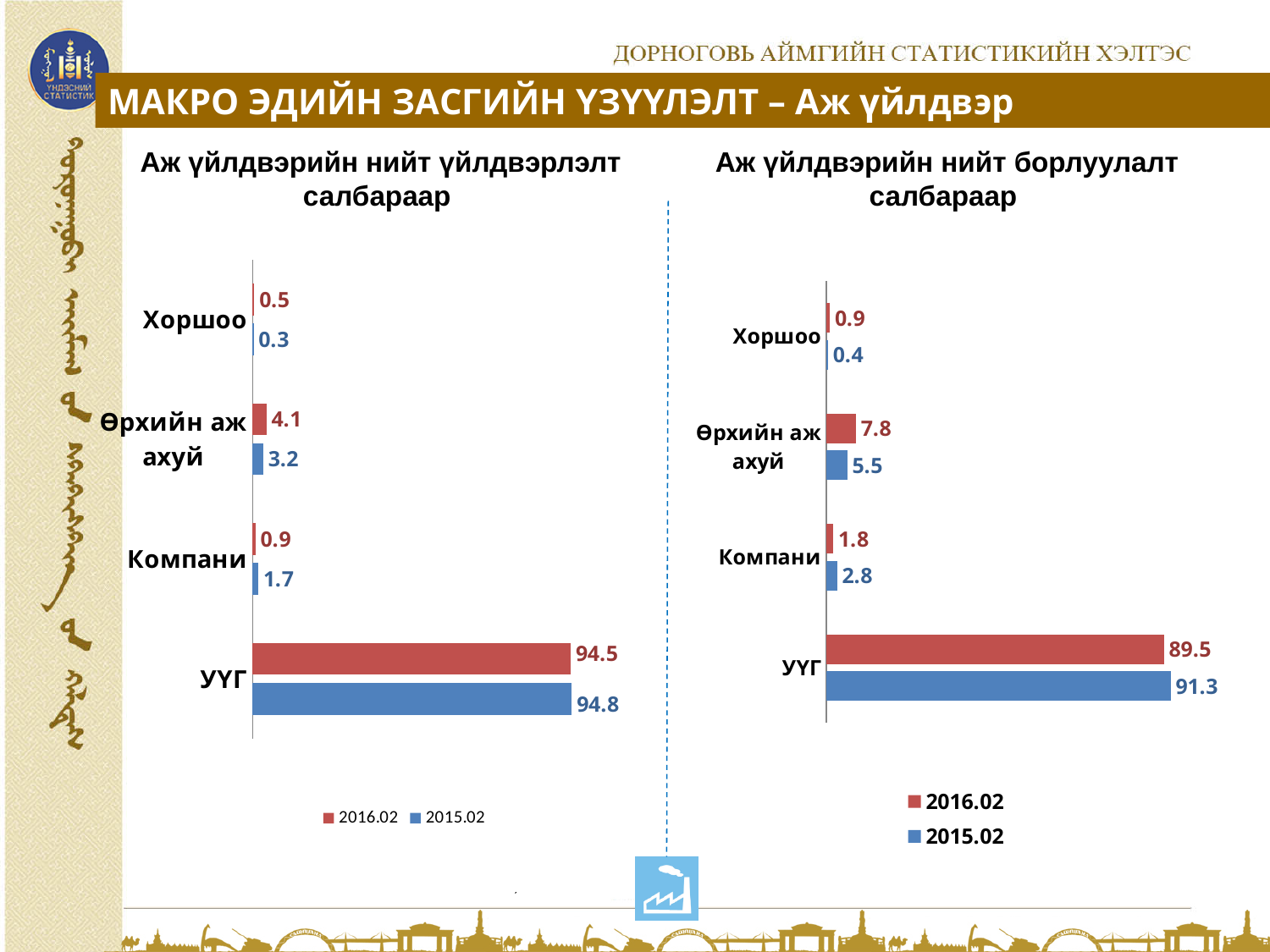
How many series does the legend of the left chart (Аж үйлдвэрийн нийт үйлдвэрлэлт салбараар) list? 2 How many categories are shown in the right chart (Аж үйлдвэрийн нийт борлуулалт салбараар)? 4 In the right chart (Аж үйлдвэрийн нийт борлуулалт салбараар), what is the 2016.02 value for Өрхийн аж ахуй? 7.8 In the right chart (Аж үйлдвэрийн нийт борлуулалт салбараар), what is the difference between the 2015.02 and 2016.02 values for УҮГ? 1.8 In the left chart (Аж үйлдвэрийн нийт үйлдвэрлэлт салбараар), which category has the highest 2016.02 value? УҮГ In the left chart (Аж үйлдвэрийн нийт үйлдвэрлэлт салбараар), which is larger for Компани: the 2016.02 value or the 2015.02 value? 2015.02 In the left chart (Аж үйлдвэрийн нийт үйлдвэрлэлт салбараар), what is the difference between the 2016.02 and 2015.02 values for Өрхийн аж ахуй? 0.9 In the left chart (Аж үйлдвэрийн нийт үйлдвэрлэлт салбараар), what is the 2015.02 value for Өрхийн аж ахуй? 3.2 In the left chart (Аж үйлдвэрийн нийт үйлдвэрлэлт салбараар), what is the 2016.02 value for УҮГ? 94.5 In the right chart (Аж үйлдвэрийн нийт борлуулалт салбараар), what is the 2015.02 value for Компани? 2.8 What type of chart is the right chart (Аж үйлдвэрийн нийт борлуулалт салбараар)? Bar chart In the right chart (Аж үйлдвэрийн нийт борлуулалт салбараар), which category has the lowest 2015.02 value? Хоршоо